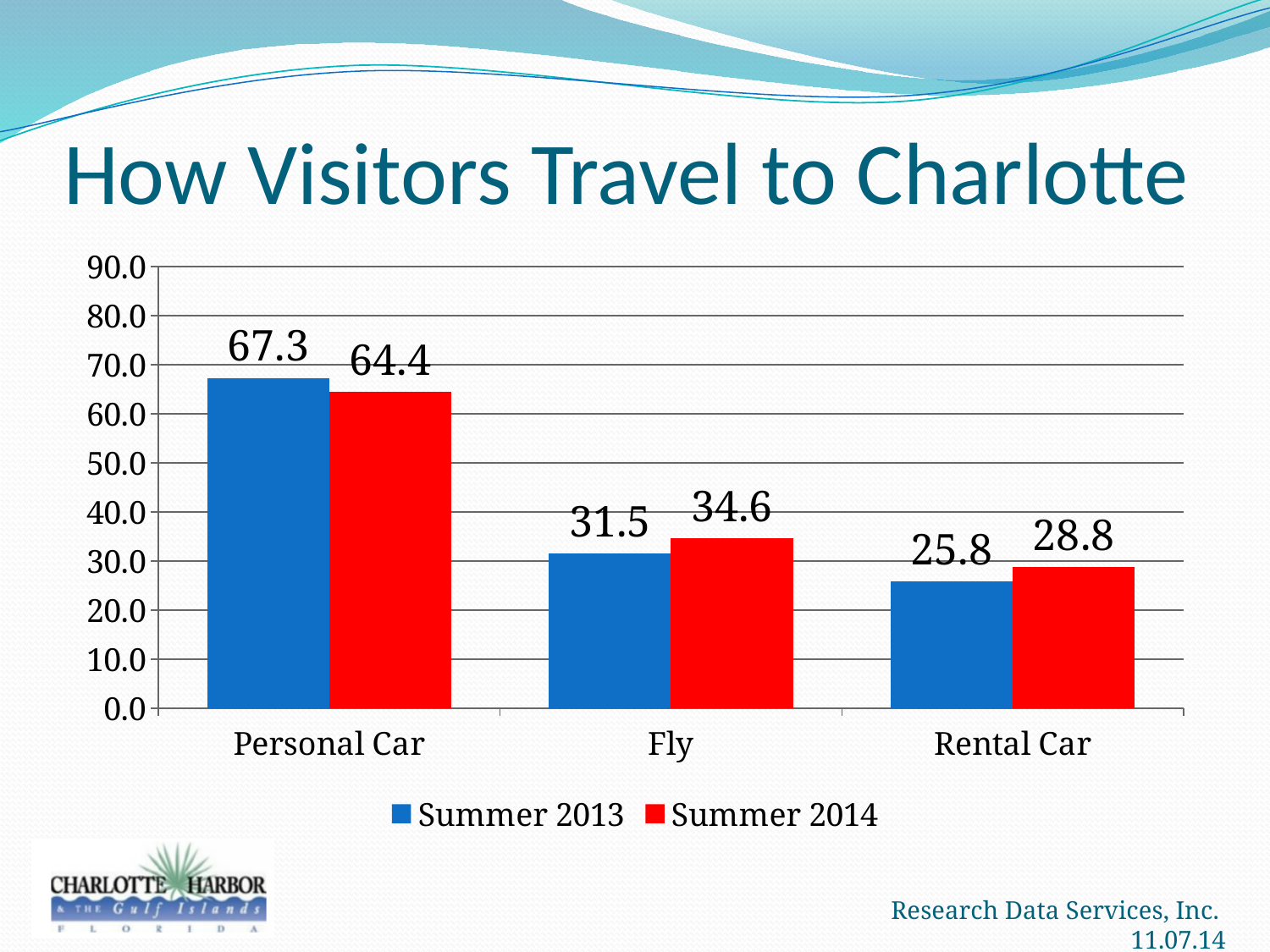
What is the value for Rental Car in Summer 2013? 25.8 What is the value for Fly in Summer 2014? 34.6 Which is larger for Fly: the Summer 2013 value or the Summer 2014 value? Summer 2014 What is the difference between the Summer 2014 values for Fly and Rental Car? 5.8 What kind of chart is shown on the slide? Bar chart How many series does the legend list? 2 What is the difference between the Summer 2013 and Summer 2014 values for Personal Car? 2.9 Is the Summer 2014 value for Rental Car greater or less than 30.0? less What is the value for Personal Car in Summer 2013? 67.3 Which category has the highest value in Summer 2014? Personal Car How many categories are shown on the x axis? 3 Which category has the lowest value in Summer 2013? Rental Car